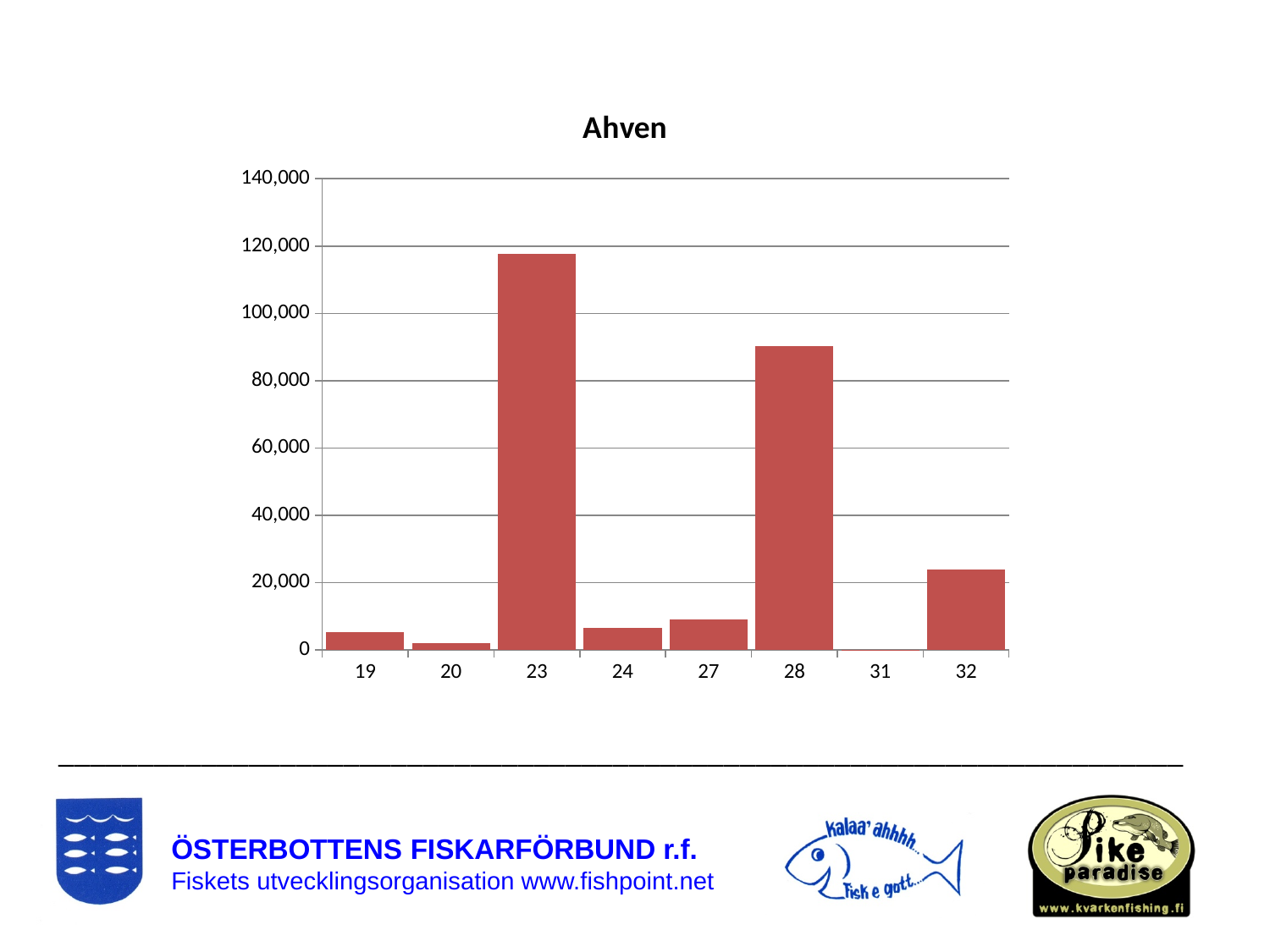
Is the value for category 28 greater or less than 80,000? greater What is the highest value shown on the y axis of the chart? 140,000 What is the title of the chart? Ahven Which has the larger value, category 28 or category 32? 28 Is the value for category 32 greater or less than 40,000? less Which has the larger value, category 27 or category 20? 27 How many categories are shown on the x axis of the chart? 8 Which category has the highest value in the chart? 23 Which category has the lowest value in the chart? 31 Is the value for category 19 greater or less than 20,000? less What kind of chart is shown on the slide? bar chart